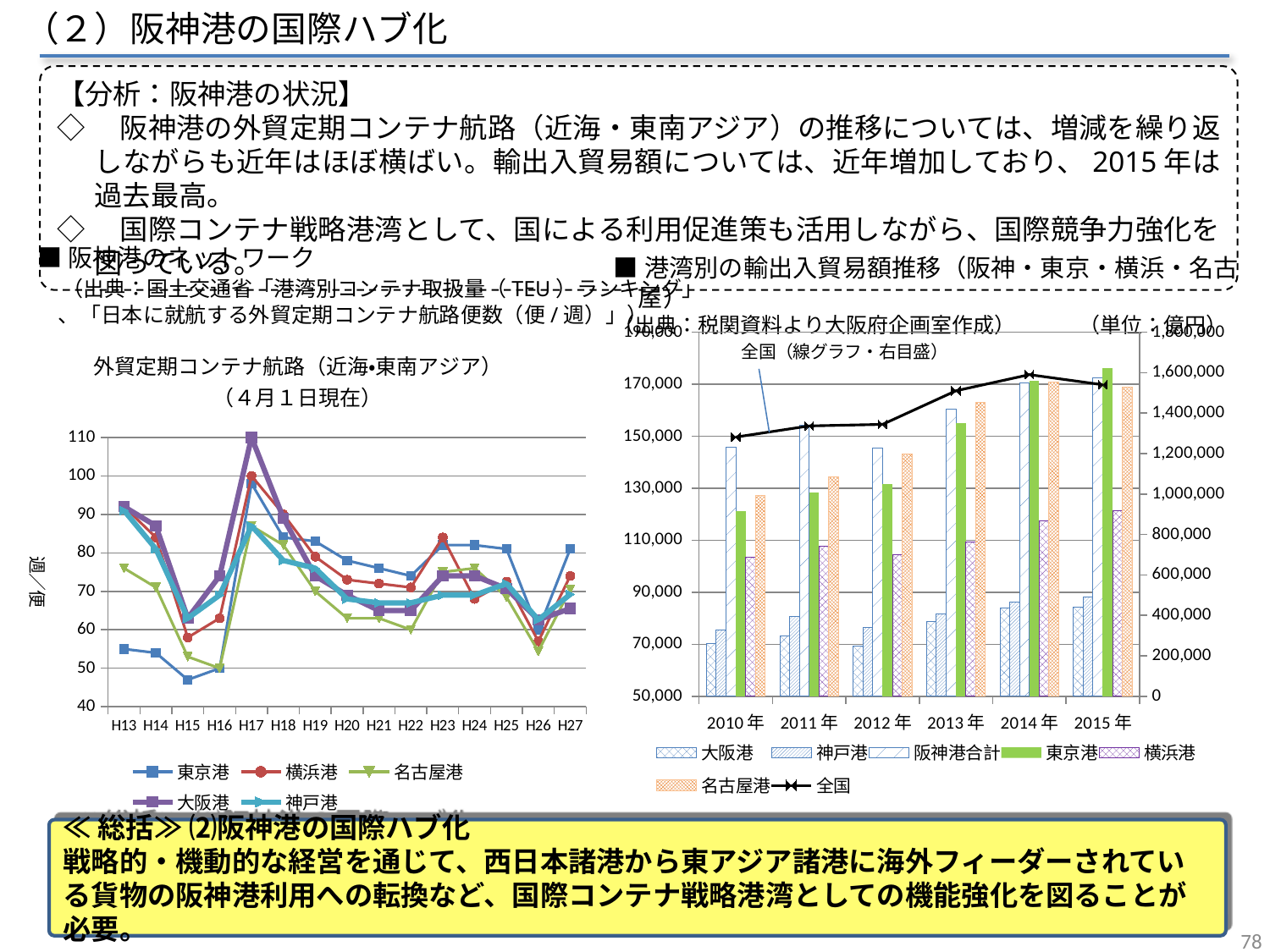
In the left chart (外貿定期コンテナ航路), in which year does 大阪港 reach its highest value? H17 In the left chart (外貿定期コンテナ航路), in which year is 東京港 at its lowest value? H15 In the right chart (港湾別の輸出入貿易額推移), is the value for 阪神港合計 in 2013年 greater or less than 150,000? greater In the right chart (港湾別の輸出入貿易額推移), how many years are shown on the x axis? 6 In the right chart (港湾別の輸出入貿易額推移), which is larger in 2012年, 東京港 or 名古屋港? 名古屋港 In the left chart (外貿定期コンテナ航路), which is larger in H15, 東京港 or 大阪港? 大阪港 In the left chart (外貿定期コンテナ航路), does the value for 大阪港 rise or fall from H17 to H22? fall In the left chart (外貿定期コンテナ航路), how many years are plotted along the x axis? 15 In the left chart (外貿定期コンテナ航路), how many series does the legend list? 5 What kind of chart is the left chart titled 外貿定期コンテナ航路（近海•東南アジア）? line chart In the right chart (港湾別の輸出入貿易額推移), how many series does the legend list? 7 In the left chart (外貿定期コンテナ航路), is the value for 東京港 in H13 greater or less than 60? less